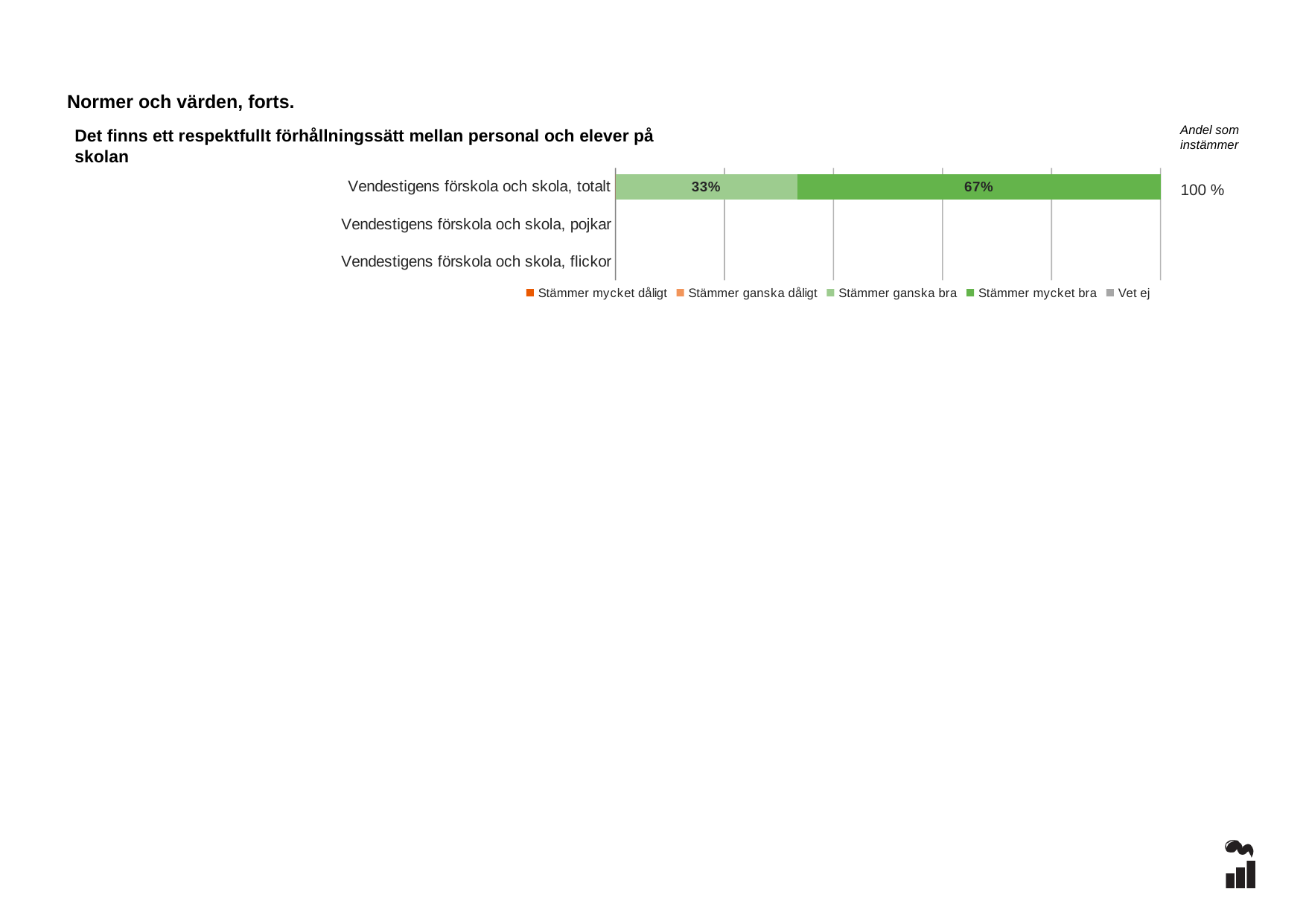
How many categories are shown on the vertical axis of the chart? 3 Which legend entry is shown in the darkest green colour? Stämmer mycket bra What is the "Andel som instämmer" value shown for Vendestigens förskola och skola, totalt? 100 % What is the difference between the "Stämmer mycket bra" and "Stämmer ganska bra" values for Vendestigens förskola och skola, totalt? 34% What is the value for "Stämmer mycket bra" for Vendestigens förskola och skola, totalt? 67% Which is larger for Vendestigens förskola och skola, totalt: "Stämmer ganska bra" or "Stämmer mycket bra"? Stämmer mycket bra What is the total of the stacked bar for Vendestigens förskola och skola, totalt? 100% Which category has the highest "Stämmer mycket bra" value? Vendestigens förskola och skola, totalt What is the value for "Stämmer ganska bra" for Vendestigens förskola och skola, totalt? 33% How many series does the legend list? 5 What is the title of the chart? Det finns ett respektfullt förhållningssätt mellan personal och elever på skolan What kind of chart is shown on the slide? bar chart